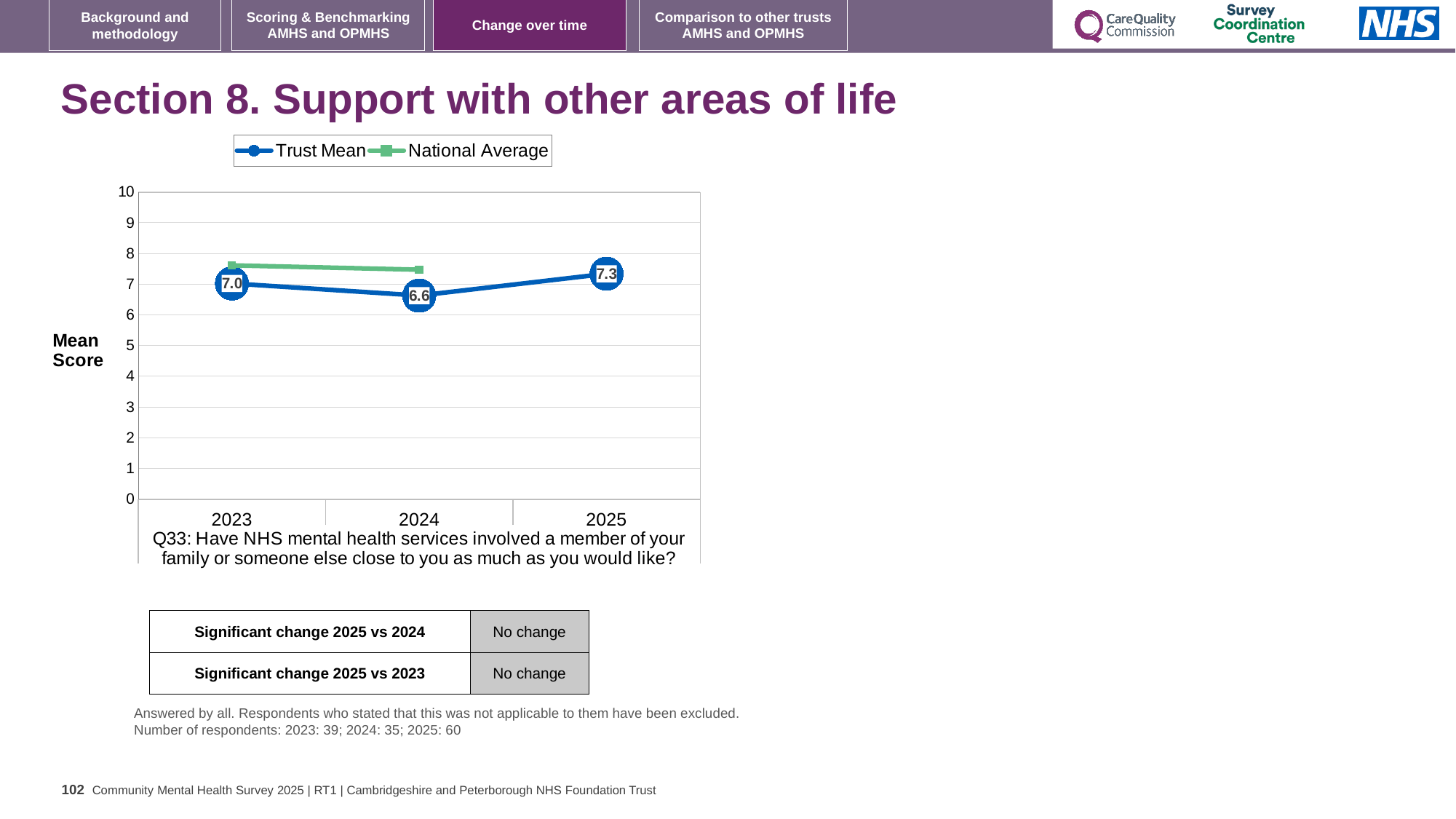
Is the National Average value for 2023 greater or less than 7? greater What is the Trust Mean score for 2023? 7.0 What is the Trust Mean score for 2024? 6.6 What kind of chart is shown on the slide? line chart What is the difference between the Trust Mean scores for 2025 and 2024? 0.7 How many series does the chart legend list? 2 In which year is the Trust Mean score highest? 2025 Which is larger, the Trust Mean score for 2023 or for 2025? 2025 What is the Trust Mean score for 2025? 7.3 In which year is the Trust Mean score lowest? 2024 Does the Trust Mean score rise or fall from 2024 to 2025? rise How many years are shown on the x axis of the chart? 3